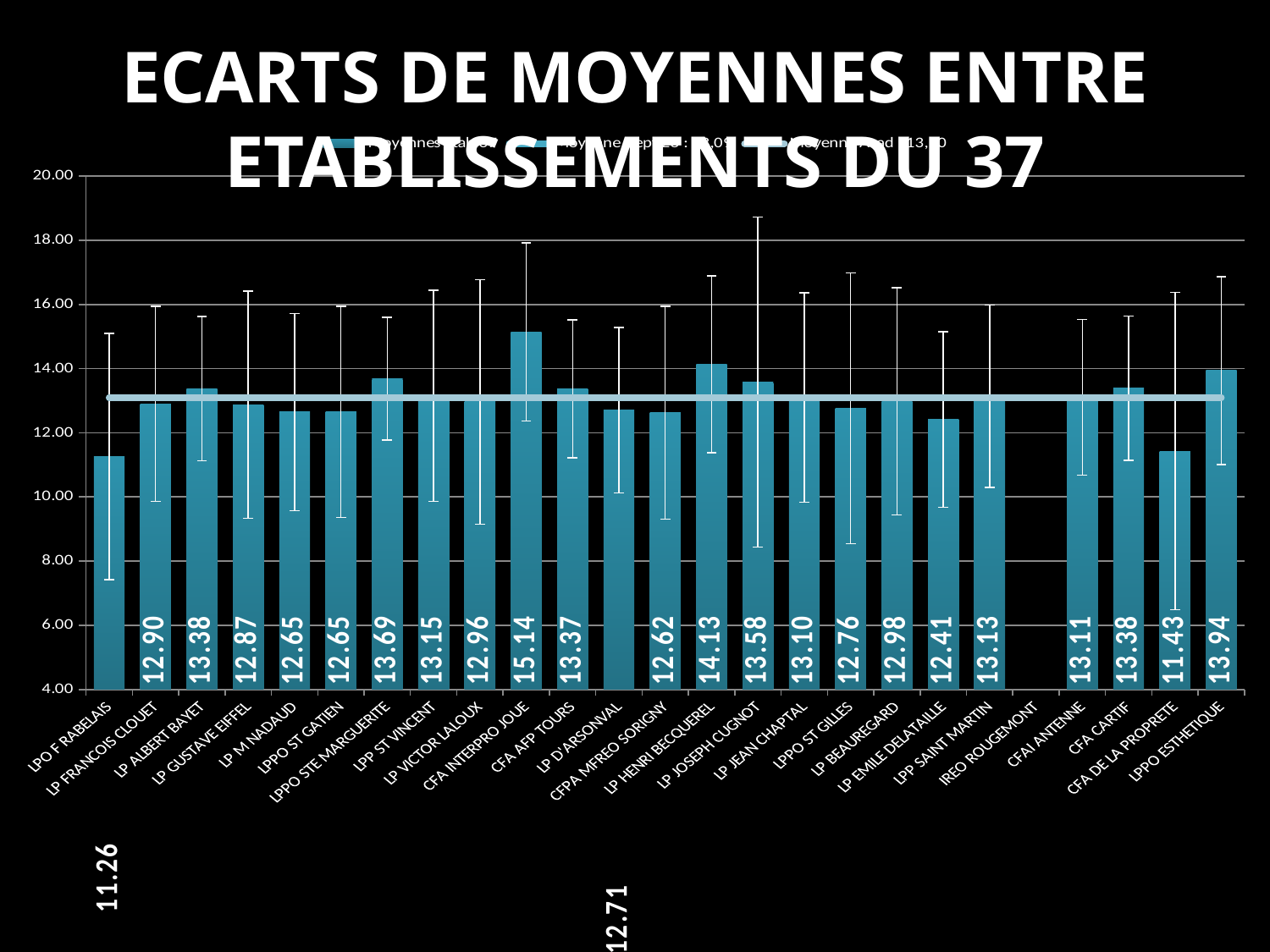
What is the difference between the values for CFA INTERPRO JOUE and LPO F RABELAIS? 3.88 How many establishments are listed on the x axis? 25 What is the difference between the values for LP HENRI BECQUEREL and LP JOSEPH CUGNOT? 0.55 What is the value for CFA DE LA PROPRETE? 11.43 Which establishment has the lowest value? LPO F RABELAIS What is the value for CFA INTERPRO JOUE? 15.14 What kind of chart is shown on the slide? combination bar and line chart What is the value for LP EMILE DELATAILLE? 12.41 Which establishment has the highest value? CFA INTERPRO JOUE Is the value for LP M NADAUD greater or less than 14.00? less Which has the larger value, LPPO STE MARGUERITE or LPPO ESTHETIQUE? LPPO ESTHETIQUE What is the value for LP D'ARSONVAL? 12.71